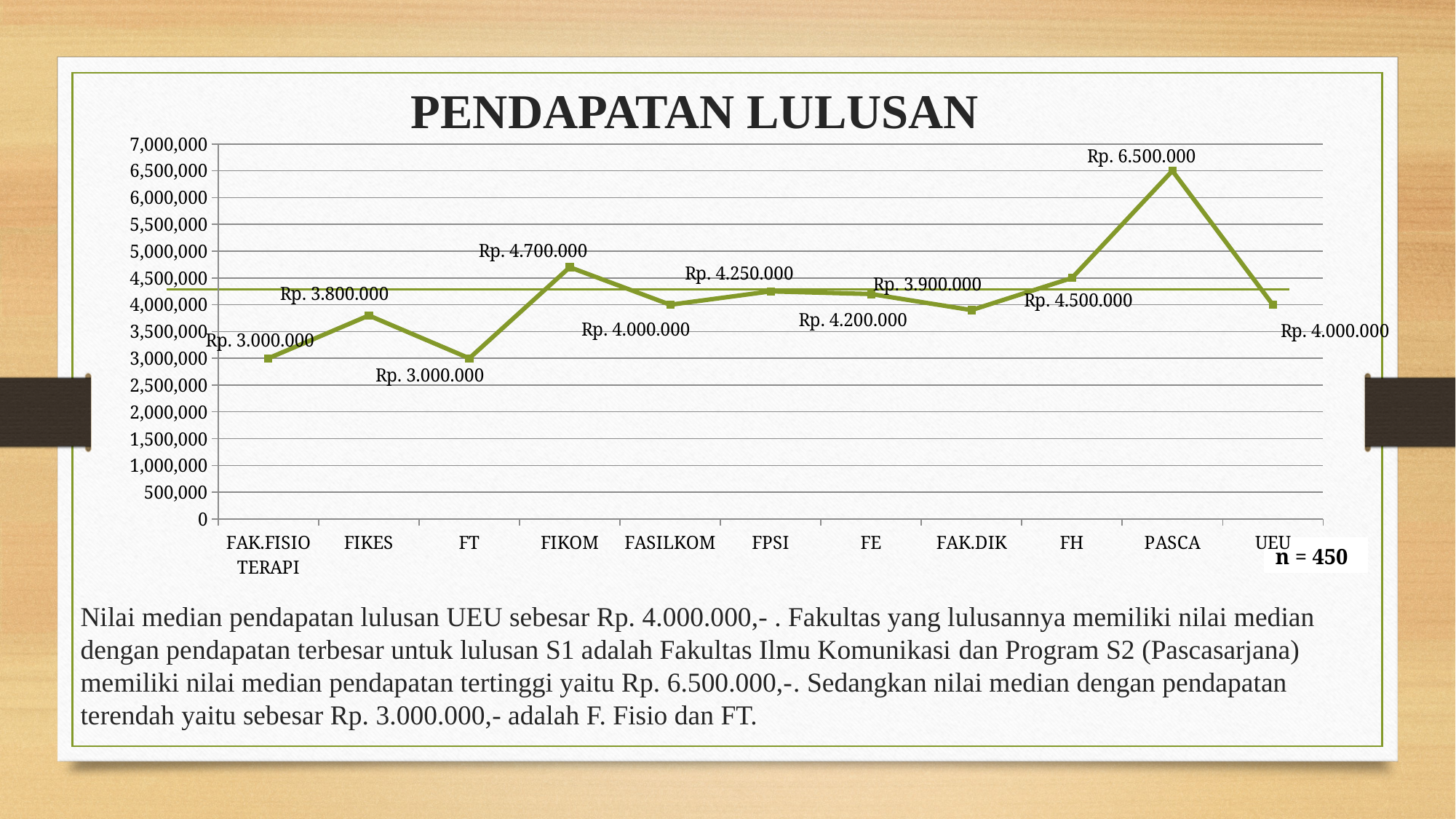
What type of chart is shown on the slide? line chart How many categories are shown on the x axis of the chart? 11 Is the value for FAK.DIK greater or less than 4,000,000? less What is the difference between the values for PASCA and FIKOM? Rp. 1.800.000 What is the title of the chart? PENDAPATAN LULUSAN Which category has the highest value? PASCA What is the value for UEU? Rp. 4.000.000 What is the sample size (n) noted on the slide? n = 450 Which is larger, the value for FH or the value for FASILKOM? FH What is the value for PASCA? Rp. 6.500.000 What is the value for FIKES? Rp. 3.800.000 What is the value for FIKOM? Rp. 4.700.000